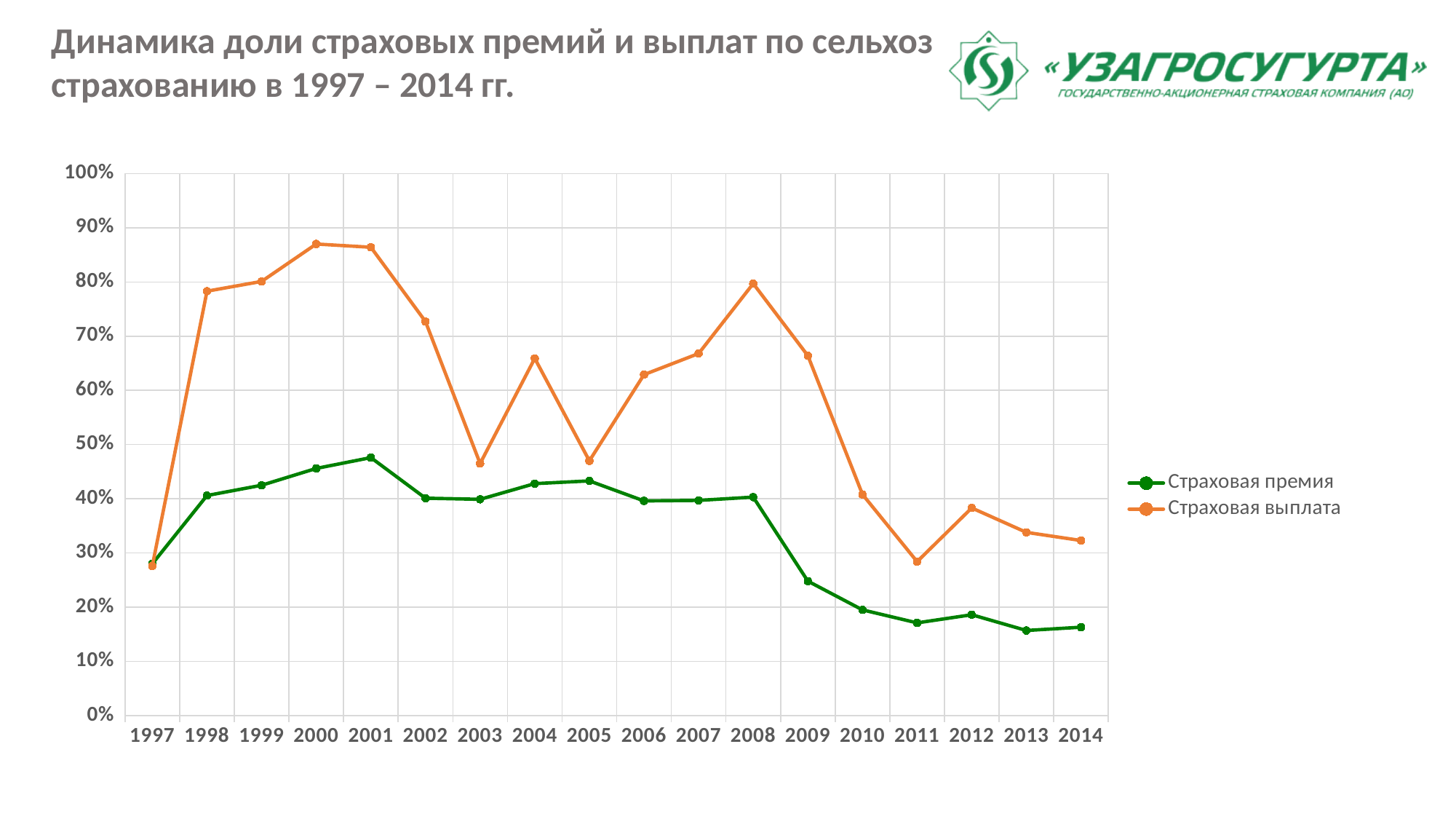
How many series does the legend list? 2 Is the value for Страховая выплата in 2000 greater or less than 80%? greater Does the Страховая премия line rise or fall from 2008 to 2014? fall Which is larger for Страховая выплата: the value in 2004 or in 2005? 2004 Which series is drawn in orange? Страховая выплата Does the Страховая выплата line rise or fall from 1997 to 2000? rise Is the value for Страховая премия in 2012 greater or less than 20%? less What kind of chart is shown on the slide? line chart How many years are plotted along the x axis? 18 Is the value for Страховая премия in 2009 greater or less than 30%? less What is the first year shown on the x axis? 1997